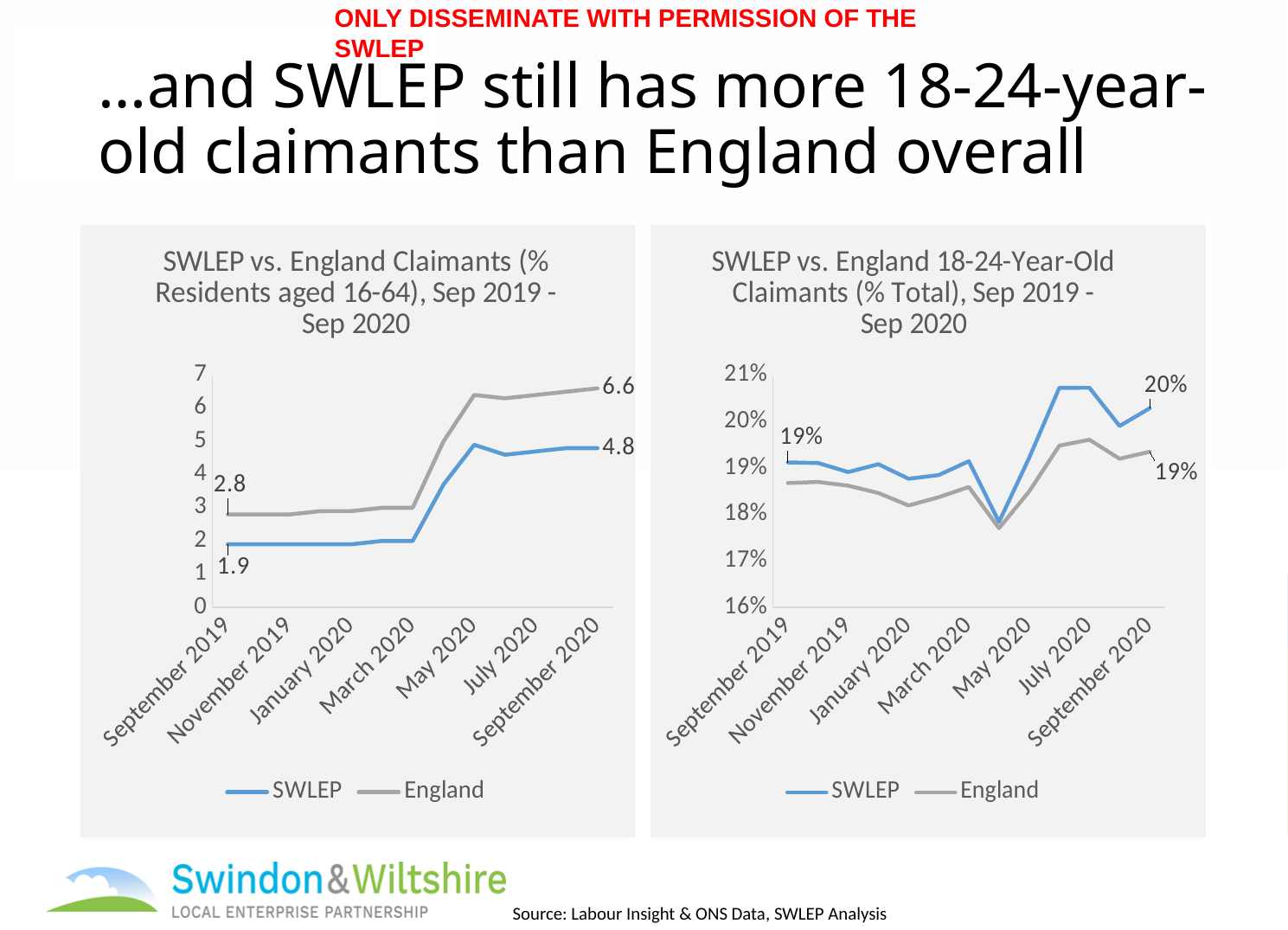
In the left chart (SWLEP vs. England Claimants, % Residents aged 16-64), what is the England value for September 2019? 2.8 In the left chart (SWLEP vs. England Claimants, % Residents aged 16-64), what is the SWLEP value for September 2020? 4.8 In the right chart (SWLEP vs. England 18-24-Year-Old Claimants, % Total), which series has the higher value in September 2020, SWLEP or England? SWLEP In the left chart (SWLEP vs. England Claimants, % Residents aged 16-64), what is the SWLEP value for September 2019? 1.9 In the left chart (SWLEP vs. England Claimants, % Residents aged 16-64), what is the England value for September 2020? 6.6 In the left chart (SWLEP vs. England Claimants, % Residents aged 16-64), is the England value for May 2020 greater or less than 6? greater What kind of chart is the left chart (SWLEP vs. England Claimants, % Residents aged 16-64)? line chart How many series does the legend of the right chart (SWLEP vs. England 18-24-Year-Old Claimants) list? 2 In the right chart (SWLEP vs. England 18-24-Year-Old Claimants, % Total), what is the SWLEP value for September 2020? 20% In the left chart (SWLEP vs. England Claimants, % Residents aged 16-64), by how much did the SWLEP value increase from September 2019 to September 2020? 2.9 In the left chart (SWLEP vs. England Claimants, % Residents aged 16-64), what is the difference between the England and SWLEP values in September 2020? 1.8 In the right chart (SWLEP vs. England 18-24-Year-Old Claimants, % Total), is the England value for May 2020 greater or less than 18%? greater